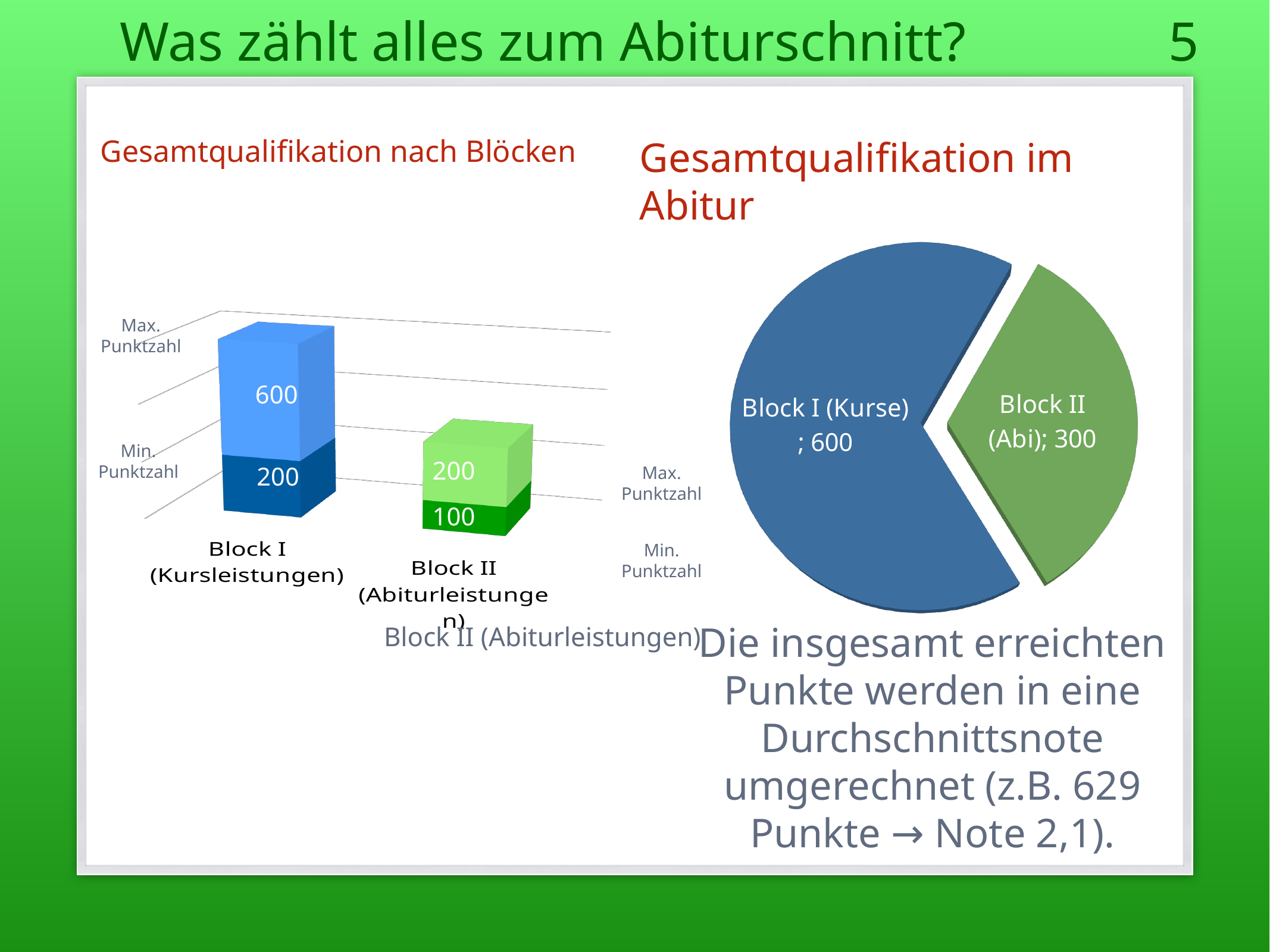
In the chart 'Gesamtqualifikation nach Blöcken', what is the Min. Punktzahl value for Block I (Kursleistungen)? 200 In the chart 'Gesamtqualifikation nach Blöcken', what is the Max. Punktzahl value for Block I (Kursleistungen)? 600 In the chart 'Gesamtqualifikation nach Blöcken', how many blocks (categories) are shown? 2 In the pie chart 'Gesamtqualifikation im Abitur', which slice is the largest? Block I (Kurse) In the chart 'Gesamtqualifikation nach Blöcken', what is the Min. Punktzahl value for Block II (Abiturleistungen)? 100 In the pie chart 'Gesamtqualifikation im Abitur', what is the value for Block I (Kurse)? 600 In the pie chart 'Gesamtqualifikation im Abitur', what is the value for Block II (Abi)? 300 What kind of chart is 'Gesamtqualifikation nach Blöcken'? Stacked bar chart In the pie chart 'Gesamtqualifikation im Abitur', what is the difference between Block I (Kurse) and Block II (Abi)? 300 In the chart 'Gesamtqualifikation nach Blöcken', what is the Max. Punktzahl value for Block II (Abiturleistungen)? 200 In the chart 'Gesamtqualifikation nach Blöcken', what is the difference between the Max. Punktzahl of Block I and the Max. Punktzahl of Block II? 400 In the chart 'Gesamtqualifikation nach Blöcken', which block has the higher Min. Punktzahl? Block I (Kursleistungen)